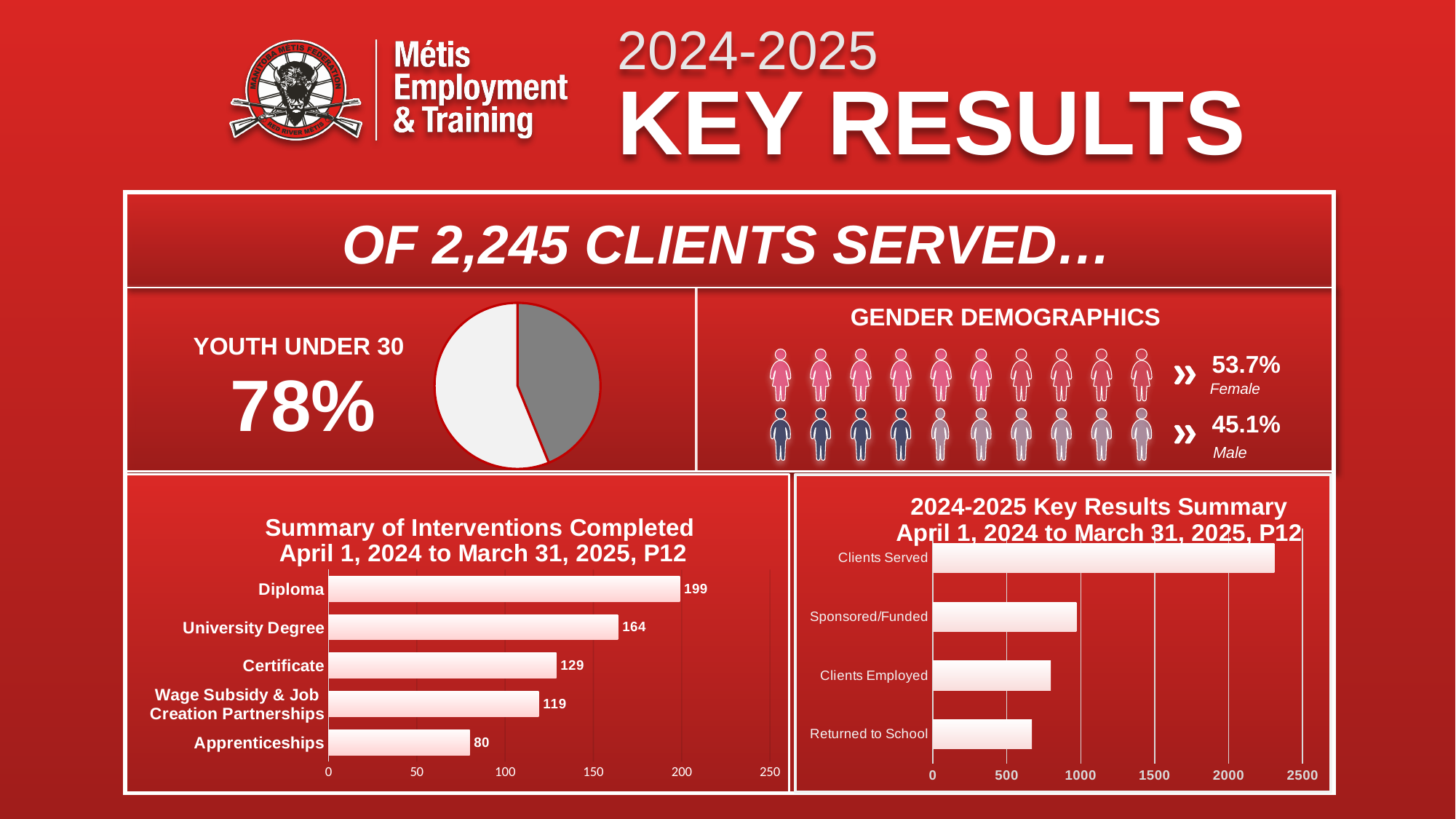
In the 2024-2025 Key Results Summary chart, is the value for Clients Served greater or less than 2000? greater In the Summary of Interventions Completed chart, which is larger, Certificate or Apprenticeships? Certificate How many categories are shown in the Summary of Interventions Completed chart? 5 In the Youth Under 30 pie chart, what share of clients are youth under 30? 78% In the 2024-2025 Key Results Summary chart, is the value for Clients Employed greater or less than 1000? less In the 2024-2025 Key Results Summary chart, which category has the lowest value? Returned to School In the Summary of Interventions Completed chart, which category has the lowest value? Apprenticeships In the Summary of Interventions Completed chart, what is the value for Wage Subsidy & Job Creation Partnerships? 119 What kind of chart is the Summary of Interventions Completed chart? Bar chart In the Summary of Interventions Completed chart, what is the value for Diploma? 199 In the Summary of Interventions Completed chart, what is the difference between University Degree and Certificate? 35 In the Summary of Interventions Completed chart, which category has the highest value? Diploma